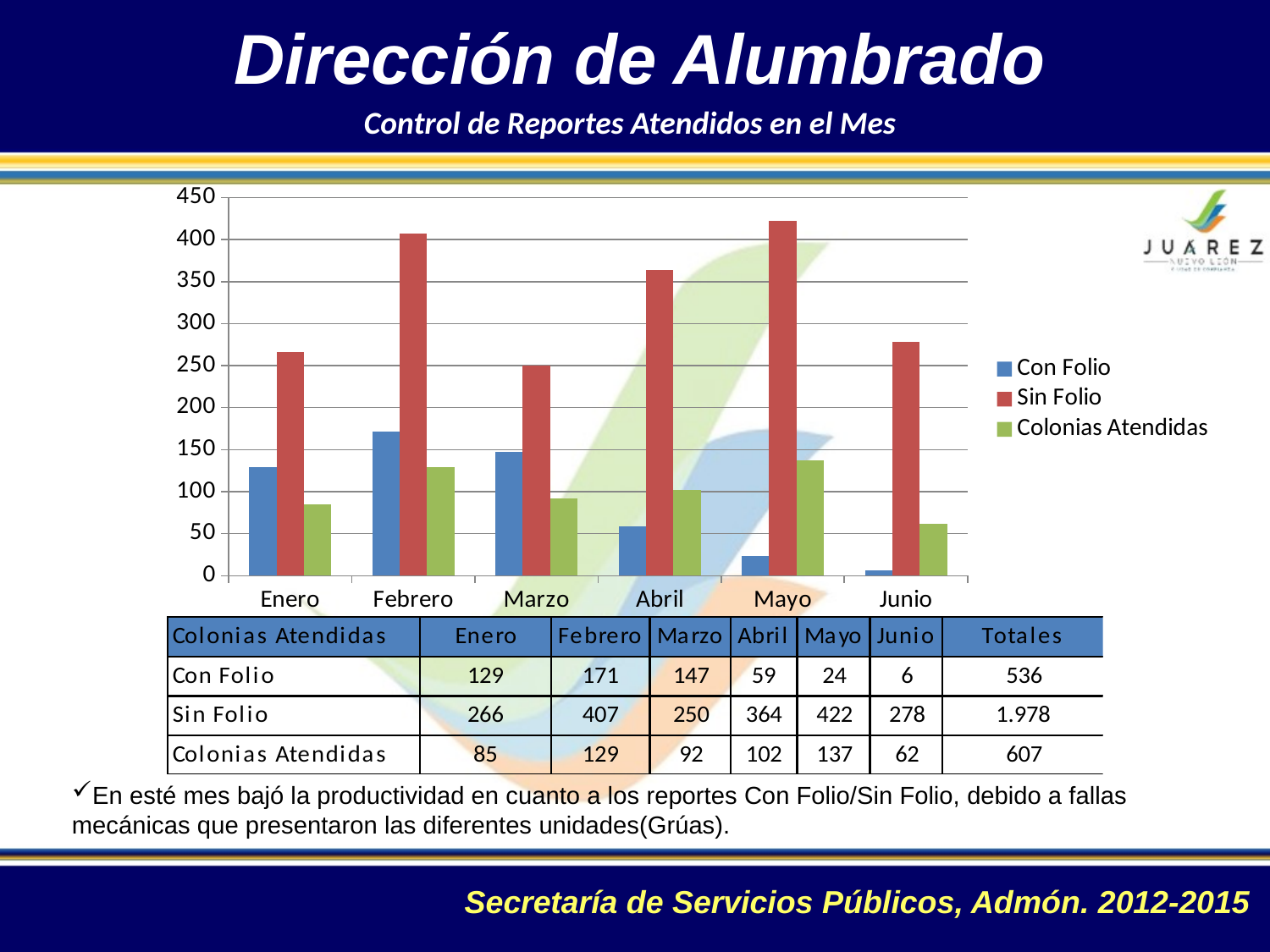
What type of chart is shown on the slide? Bar chart In which month is the Sin Folio value highest? Mayo In which month is the Con Folio value lowest? Junio How many series does the legend list? 3 What is the Con Folio value for Febrero? 171 How many months are shown on the x axis? 6 Do the Con Folio values rise or fall from Marzo to Junio? Fall Is the Sin Folio value for Febrero greater or less than 400? greater What is the Sin Folio value for Mayo? 422 What is the Colonias Atendidas value for Junio? 62 Which is larger in Abril: Colonias Atendidas or Con Folio? Colonias Atendidas What is the difference between the Sin Folio and Con Folio values in Enero? 137